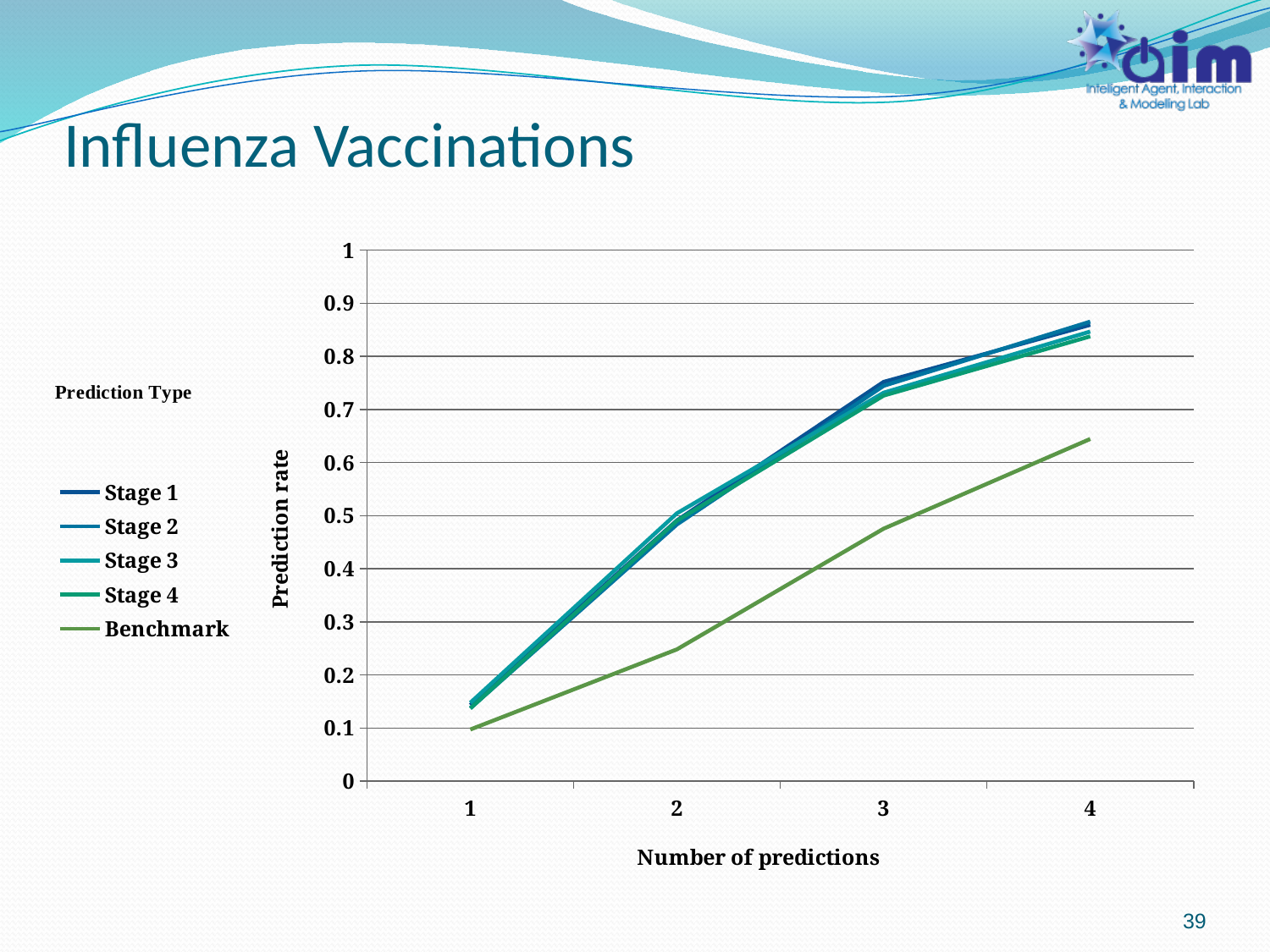
Do the Benchmark values rise or fall as the number of predictions increases? rise Which series has the lowest prediction rate at 4 predictions? Benchmark Do the Stage 1 values rise or fall along the x axis? rise How many series does the legend list? 5 At 4 predictions, which is larger: Stage 1 or Benchmark? Stage 1 Is the Benchmark value at 2 predictions greater or less than 0.3? less What is the title of the y axis? Prediction rate What kind of chart is shown on the slide? line chart What is the title of the x axis? Number of predictions How many points are on the x axis (Number of predictions)? 4 Is the Benchmark value at 4 predictions greater or less than 0.6? greater Is the Stage 1 value at 4 predictions greater or less than 0.8? greater